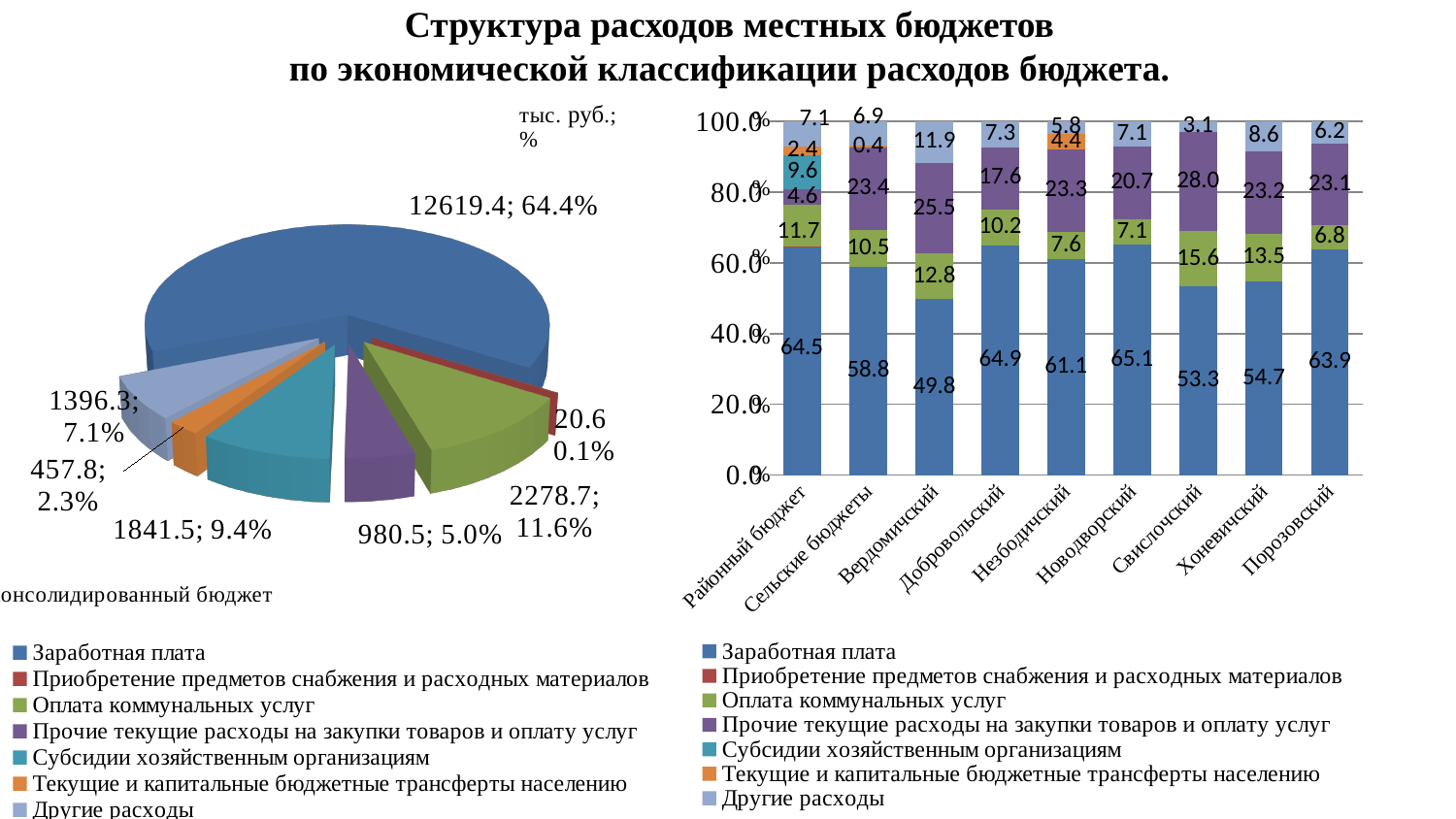
On the stacked bar chart (right), which is larger: the Оплата коммунальных услуг value for Свислочский or for Порозовский? Свислочский On the pie chart (left), which category has the smallest slice? Приобретение предметов снабжения и расходных материалов On the stacked bar chart (right), how many series does the legend list? 7 On the pie chart (left), what share does Оплата коммунальных услуг have? 11.6% On the stacked bar chart (right), what is the Заработная плата value for Вердомичский? 49.8 On the stacked bar chart (right), which category has the lowest Заработная плата value? Вердомичский On the stacked bar chart (right), which category has the highest Заработная плата value? Новодворский What type of chart is shown on the right side of the slide? Stacked bar chart On the stacked bar chart (right), what is the difference between the Заработная плата values for Районный бюджет and Сельские бюджеты? 5.7 On the stacked bar chart (right), how many categories are shown on the x axis? 9 On the pie chart (left), what is the value shown for Субсидии хозяйственным организациям? 1841.5 On the pie chart (left), what value and share are shown for Заработная плата? 12619.4; 64.4%